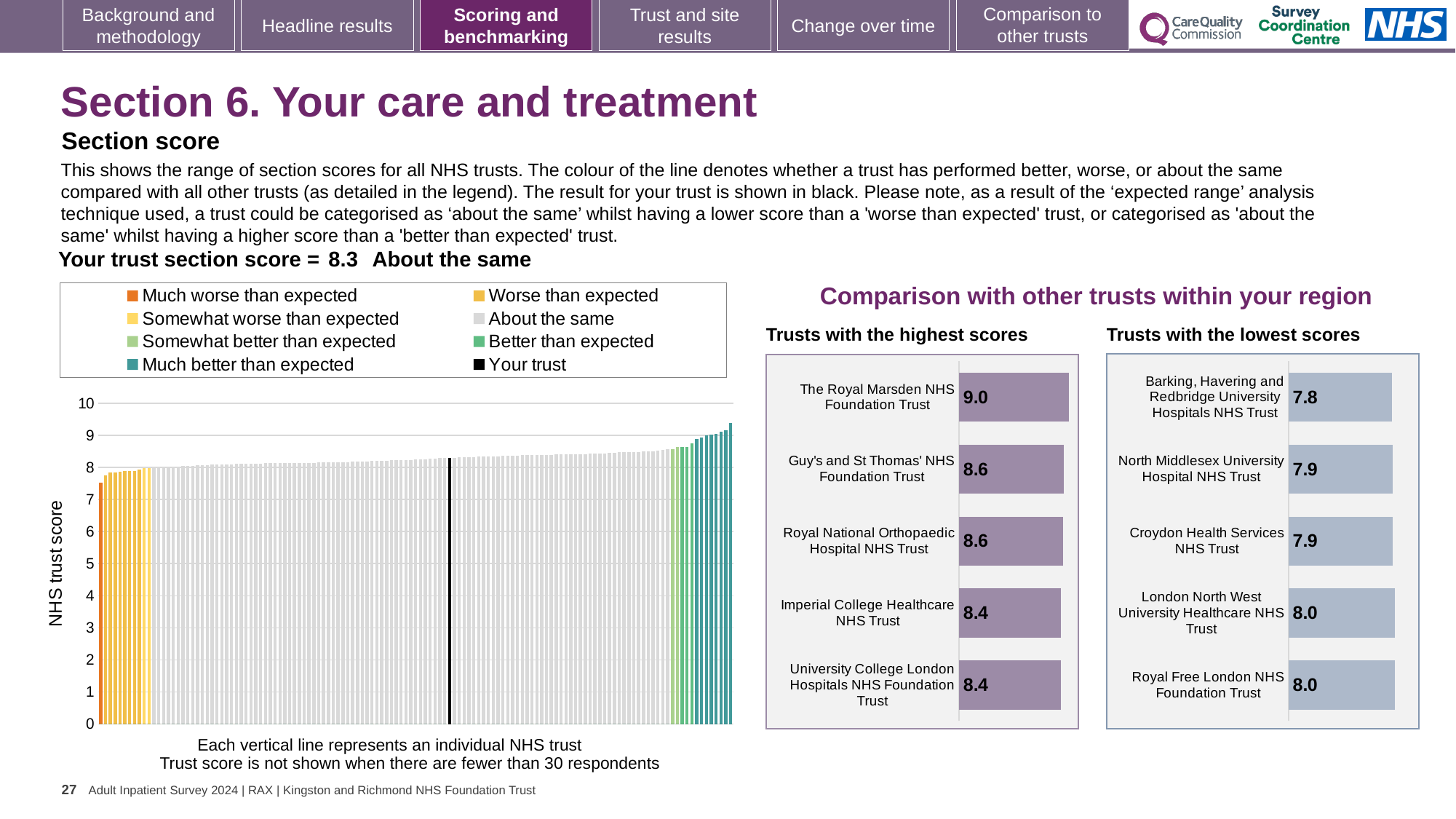
How many entries does the legend of the NHS trust score chart on the left list? 8 In the NHS trust score chart on the left, is the value for the black 'Your trust' bar greater or less than 8? greater In the 'Trusts with the highest scores' chart, which trust has the highest score? The Royal Marsden NHS Foundation Trust In the 'Trusts with the highest scores' chart, what is the score for Imperial College Healthcare NHS Trust? 8.4 In the 'Trusts with the lowest scores' chart, which has the larger score: Royal Free London NHS Foundation Trust or North Middlesex University Hospital NHS Trust? Royal Free London NHS Foundation Trust In the 'Trusts with the highest scores' chart, what is the difference between the scores of The Royal Marsden NHS Foundation Trust and University College London Hospitals NHS Foundation Trust? 0.6 In the NHS trust score chart on the left, do the bar values rise or fall from left to right? rise How many trusts are shown in the 'Trusts with the lowest scores' chart? 5 In the 'Trusts with the highest scores' chart, what is the score for The Royal Marsden NHS Foundation Trust? 9.0 In the 'Trusts with the lowest scores' chart, what is the score for Croydon Health Services NHS Trust? 7.9 In the 'Trusts with the lowest scores' chart, what is the score for Barking, Havering and Redbridge University Hospitals NHS Trust? 7.8 In the 'Trusts with the lowest scores' chart, which trust has the lowest score? Barking, Havering and Redbridge University Hospitals NHS Trust